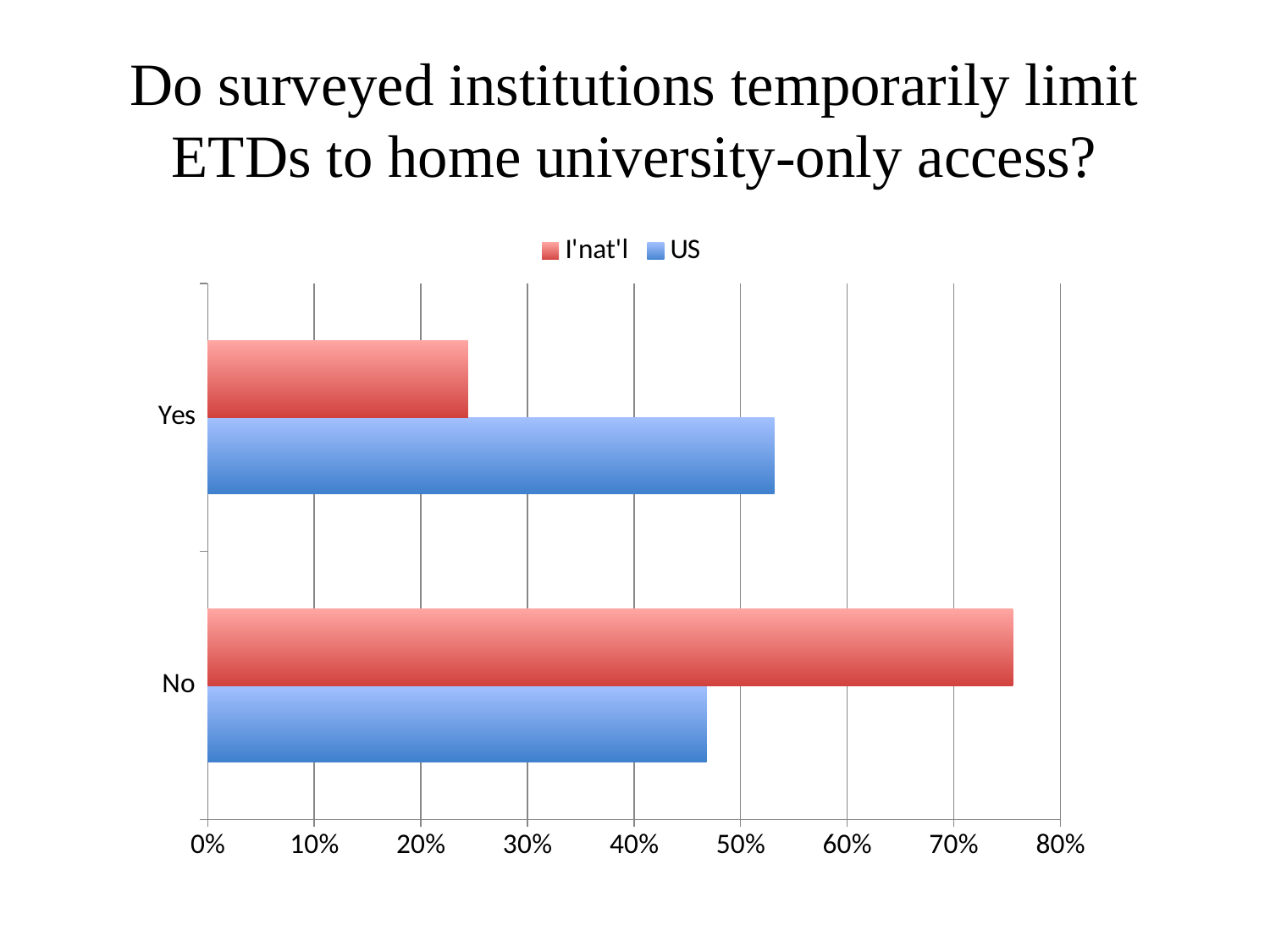
Which category has the highest I'nat'l value? No Is the US value for No greater or less than 50%? less Which series is shown in red? I'nat'l Is the I'nat'l value for No greater or less than 70%? greater Which bar is the shortest in the chart? I'nat'l for Yes How many categories are shown on the vertical axis? 2 For the No category, which series has the larger value, I'nat'l or US? I'nat'l For the Yes category, which series has the larger value, I'nat'l or US? US What kind of chart is shown on the slide? bar chart How many series does the legend list? 2 Is the US value for Yes greater or less than 50%? greater